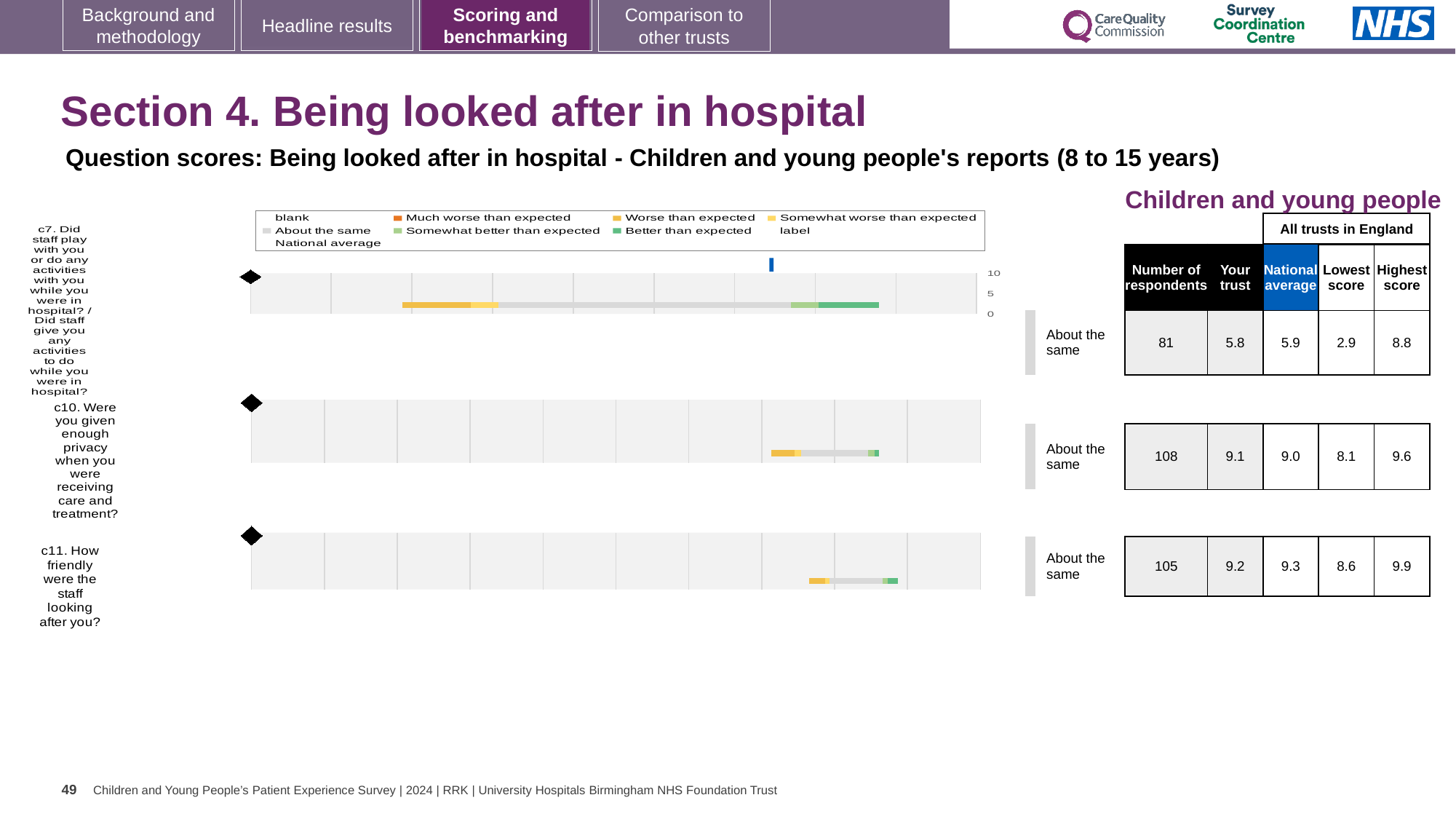
How many respondents answered question c7? 81 What is the difference between the highest score and the lowest score across all trusts in England for c7? 5.9 What is the 'Your trust' score for c10 (Were you given enough privacy when you were receiving care and treatment?)? 9.1 What benchmark category is shown for c7? About the same Which question has the highest 'Your trust' score? c11 How many survey questions are plotted on the chart? 3 What is the lowest score across all trusts in England for c11? 8.6 What is the difference between the national average and the 'Your trust' score for c11? 0.1 What kind of chart is used to show the question scores? Bar chart For c10, which is larger: the 'Your trust' score or the national average? Your trust What is the national average score for c11 (How friendly were the staff looking after you?)? 9.3 Which question has the lowest 'Your trust' score? c7